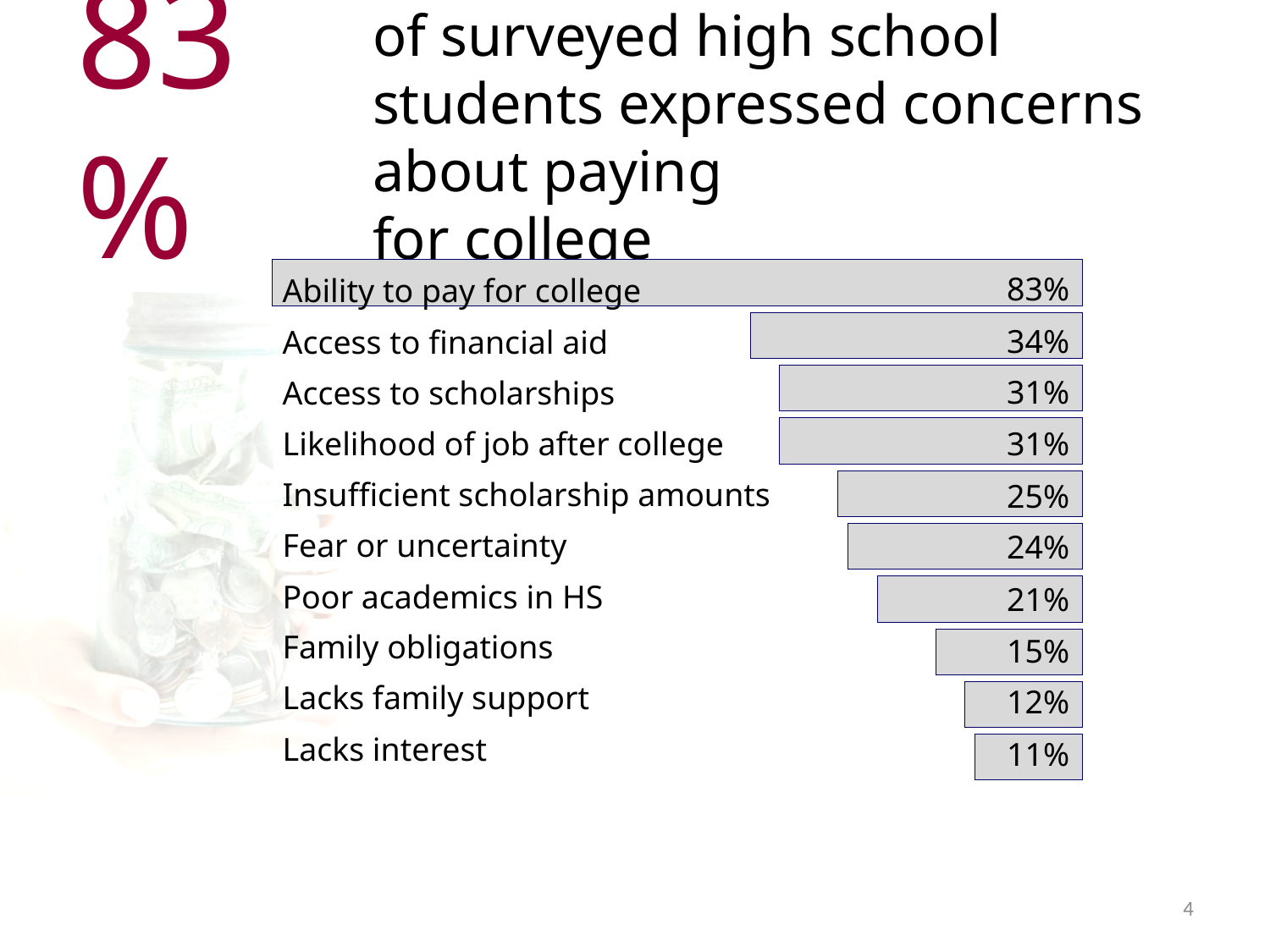
What is the difference between the values for Ability to pay for college and Access to financial aid? 49% Which is larger, the value for Poor academics in HS or the value for Family obligations? Poor academics in HS Which two categories share the value 31%? Access to scholarships and Likelihood of job after college What is the value for Fear or uncertainty? 24% Which category has the highest value? Ability to pay for college How many categories are shown in the chart? 10 Which category has the lowest value? Lacks interest What is the value for Ability to pay for college? 83% What is the value for Lacks family support? 12% What kind of chart is shown on the slide? Bar chart What is the value for Access to financial aid? 34% What is the difference between the values for Insufficient scholarship amounts and Family obligations? 10%